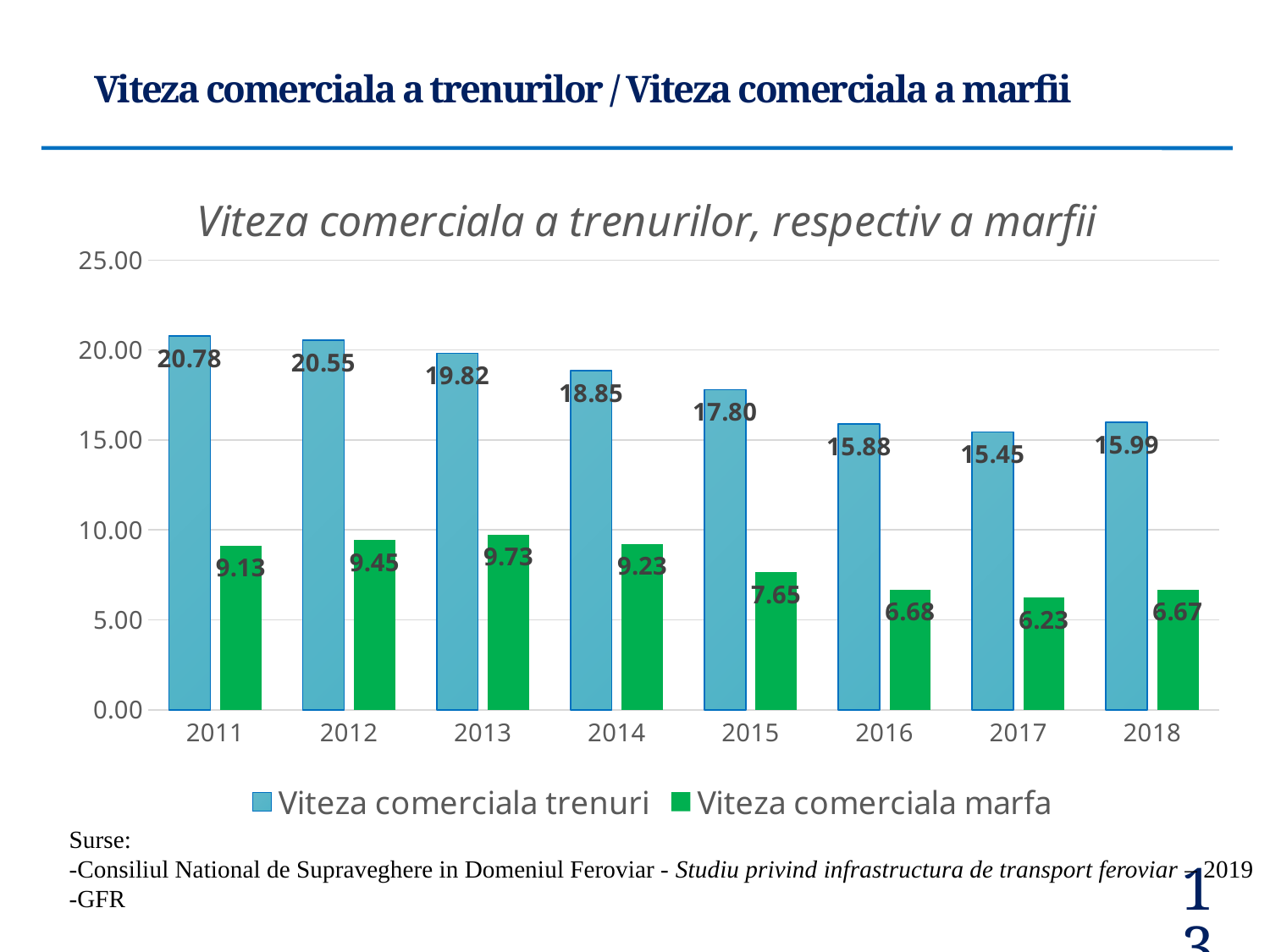
Which year has the highest value for Viteza comerciala trenuri? 2011 Is the value of Viteza comerciala trenuri for 2015 greater or less than 15.00? greater How many years are shown on the x axis? 8 Which is larger: Viteza comerciala marfa in 2012 or in 2015? 2012 What is the value of Viteza comerciala marfa for 2017? 6.23 What is the value of Viteza comerciala trenuri for 2011? 20.78 Does Viteza comerciala trenuri rise or fall from 2011 to 2017? fall Which year has the lowest value for Viteza comerciala marfa? 2017 How many series does the legend list? 2 What is the difference between Viteza comerciala trenuri in 2011 and in 2018? 4.79 What is the value of Viteza comerciala marfa for 2013? 9.73 What kind of chart is shown on the slide? bar chart